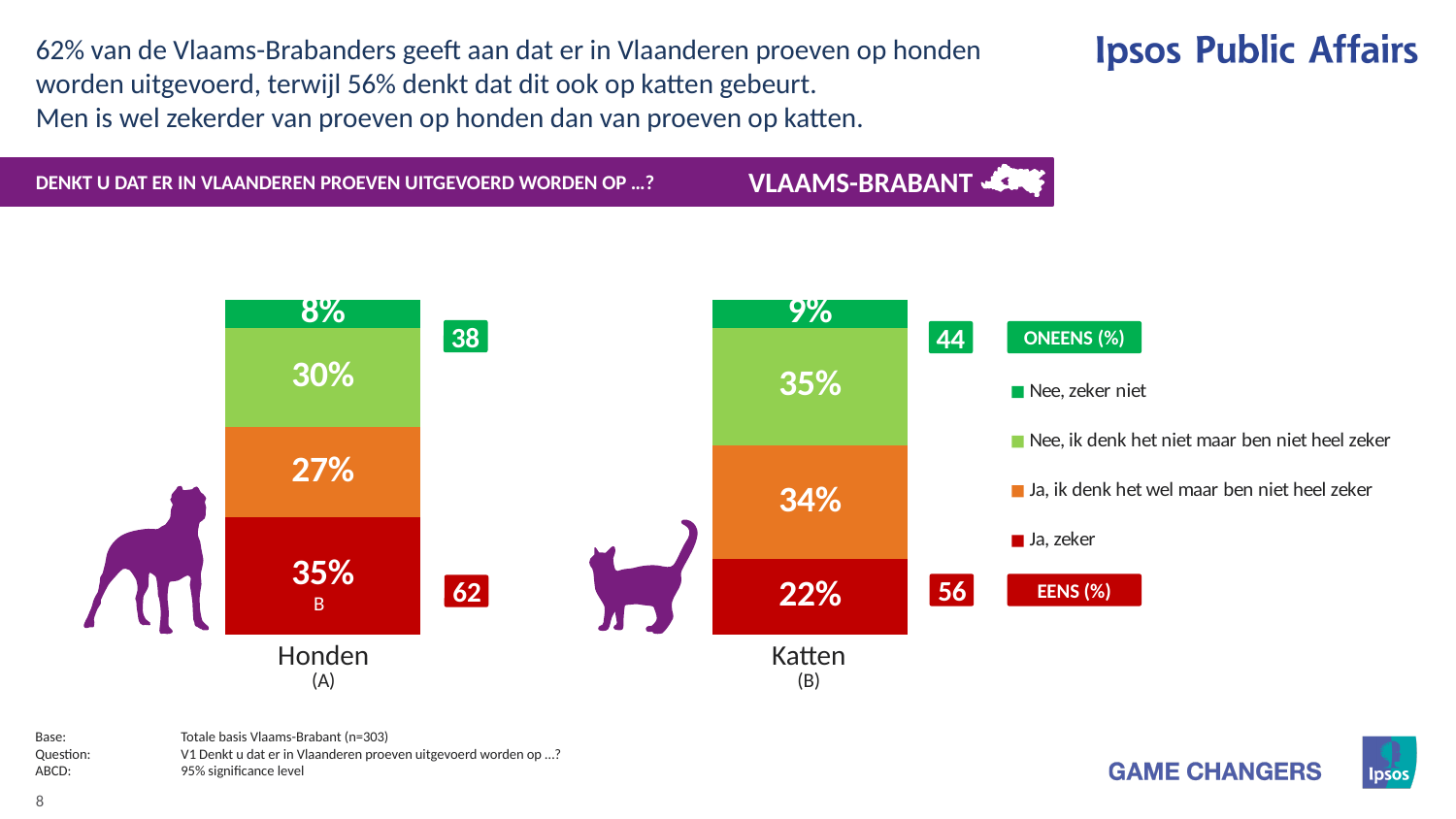
Which category has the larger "Ja, zeker" share, Honden or Katten? Honden What is the value of "Nee, zeker niet" for Honden? 8% How many series does the legend list? 4 What is the difference between the "Ja, zeker" values for Honden and Katten? 13 percentage points What is the EENS (%) total shown for Katten? 56 What is the ONEENS (%) total shown for Honden? 38 What kind of chart is shown on the slide? Stacked bar chart How many categories are shown on the x axis? 2 What is the value of "Ja, ik denk het wel maar ben niet heel zeker" for Honden? 27% What percentage of respondents answered "Ja, zeker" for Honden? 35% What is the value of "Nee, ik denk het niet maar ben niet heel zeker" for Katten? 35% What percentage of respondents answered "Ja, zeker" for Katten? 22%